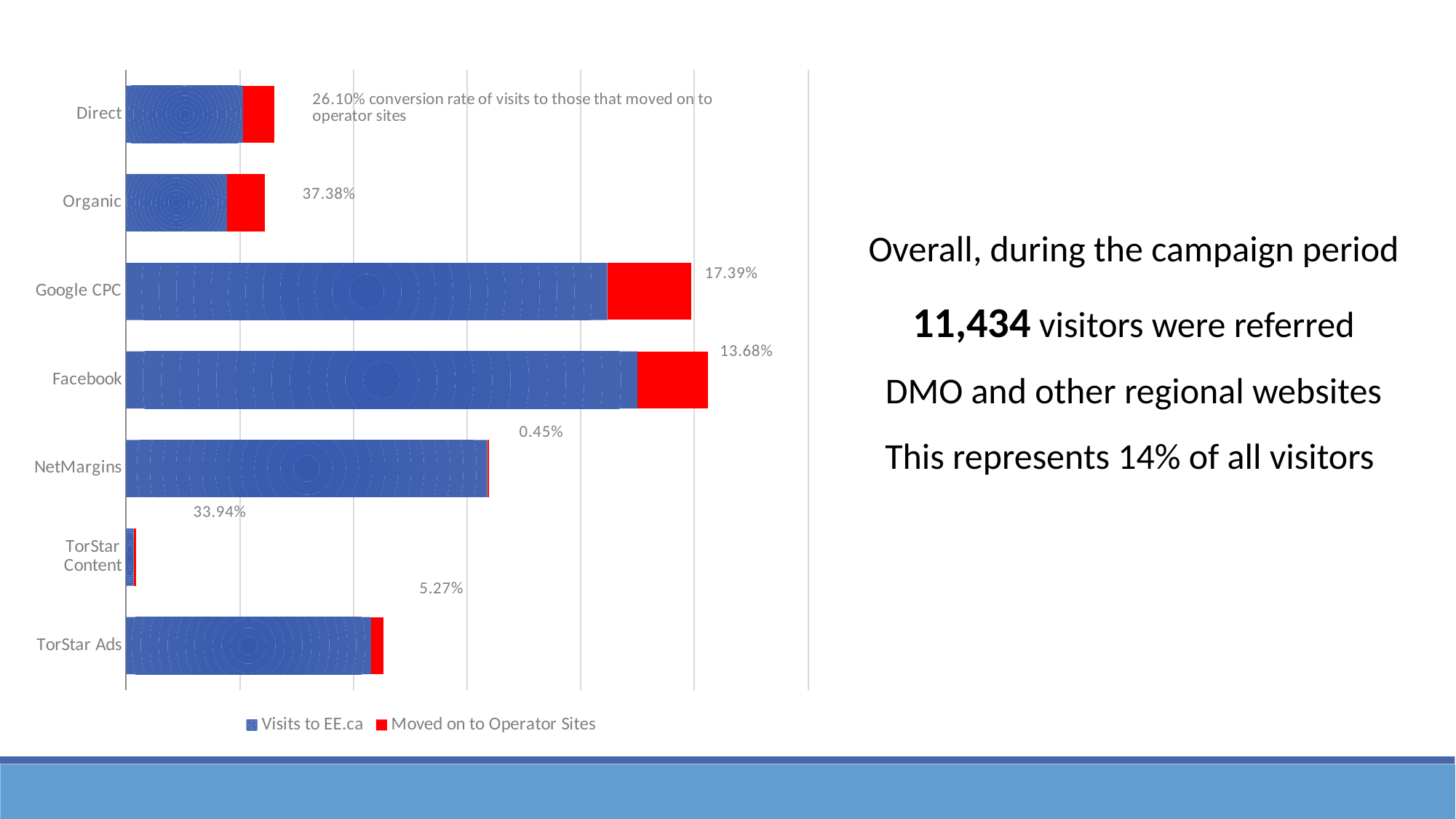
Which category has the shortest total bar on the chart? TorStar Content What conversion rate is labelled for the Direct category? 26.10% What conversion rate is labelled for the Organic category? 37.38% What is the difference between the Organic and Direct conversion rates labelled on the chart? 11.28 percentage points How many series does the chart legend list? 2 Which colour represents the Moved on to Operator Sites series in the legend? Red Which has a larger Moved on to Operator Sites segment, Direct or TorStar Ads? Direct What conversion rate is labelled for Google CPC? 17.39% Which has more Visits to EE.ca, Google CPC or Direct? Google CPC What kind of chart is shown on the slide? Stacked bar chart How many traffic source categories are plotted on the chart? 7 What conversion rate is labelled for Facebook? 13.68%